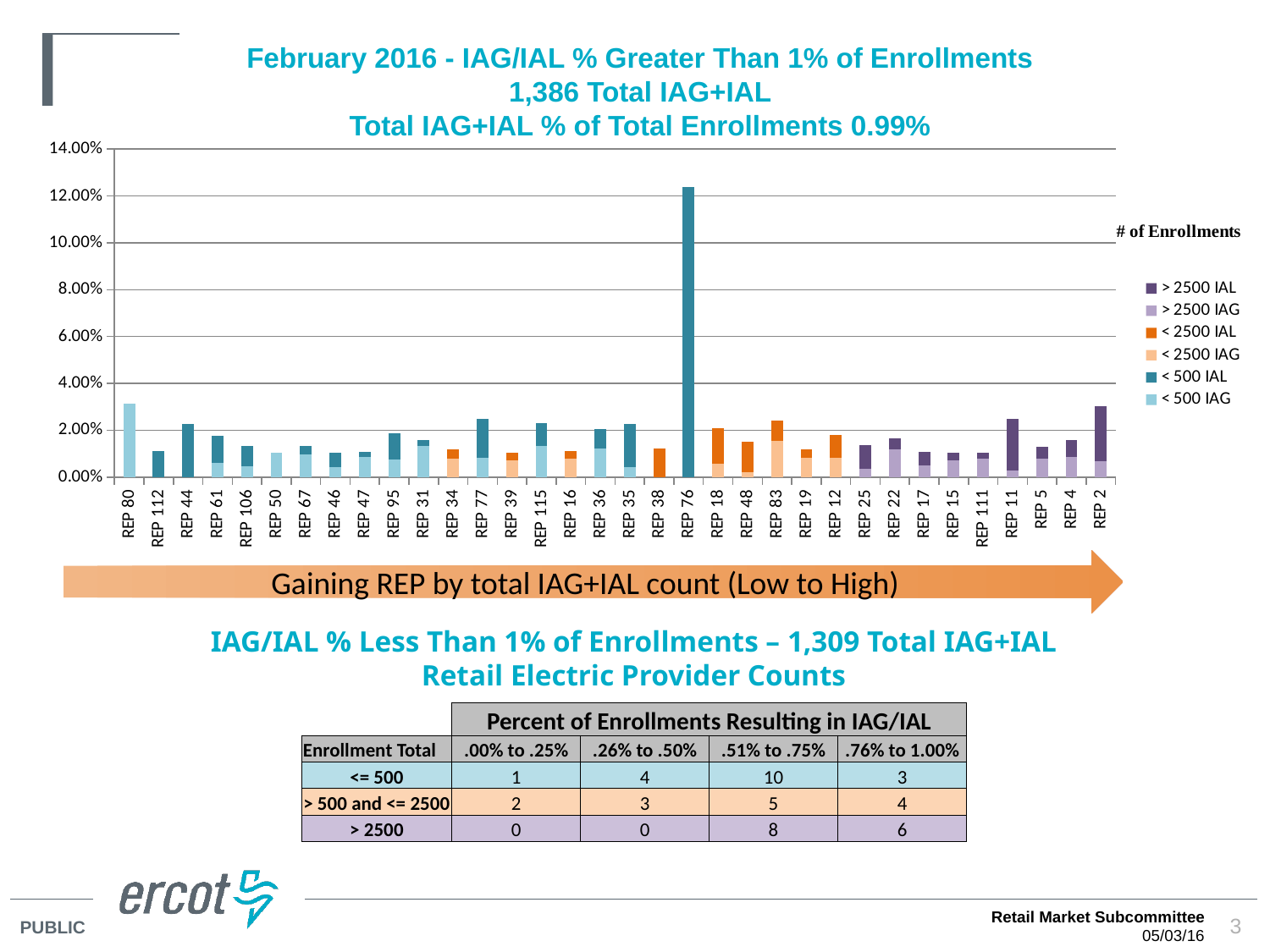
What is the title shown above the chart's legend? # of Enrollments Which has the larger total value, REP 76 or REP 80? REP 76 Is the value for REP 80 greater or less than 2.00%? greater How many REP categories are plotted along the x axis of the chart? 34 Which REP has the highest total IAG/IAL percentage in the chart? REP 76 Is the value for REP 50 greater or less than 2.00%? less How many series does the chart's legend list? 6 Is the value for REP 76 greater or less than 10.00%? greater What is the highest value shown on the chart's y axis? 14.00% Which has the larger total value, REP 80 or REP 112? REP 80 What kind of chart is shown on the slide? Stacked bar chart